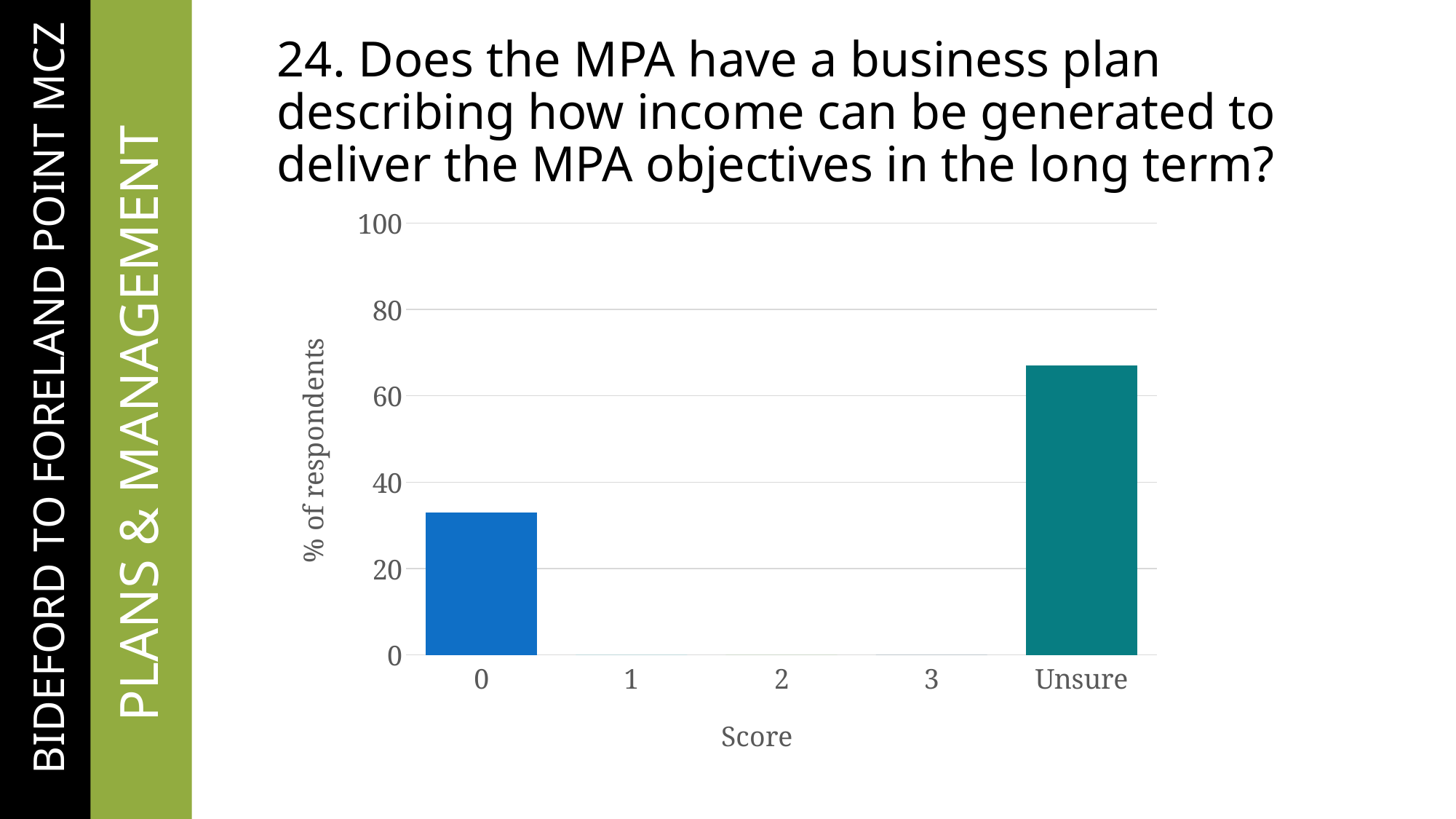
How many score categories have a visible bar? 2 Which is larger, the value for score 0 or the value for Unsure? Unsure What kind of chart is shown on the slide? bar chart What is the label of the x axis? Score How many score categories are shown on the x axis? 5 Is the value for Unsure greater or less than 80? less Is the value for score 0 greater or less than 20? greater Is the value for Unsure greater or less than 60? greater What is the label of the y axis? % of respondents Which score category has the highest percentage of respondents? Unsure